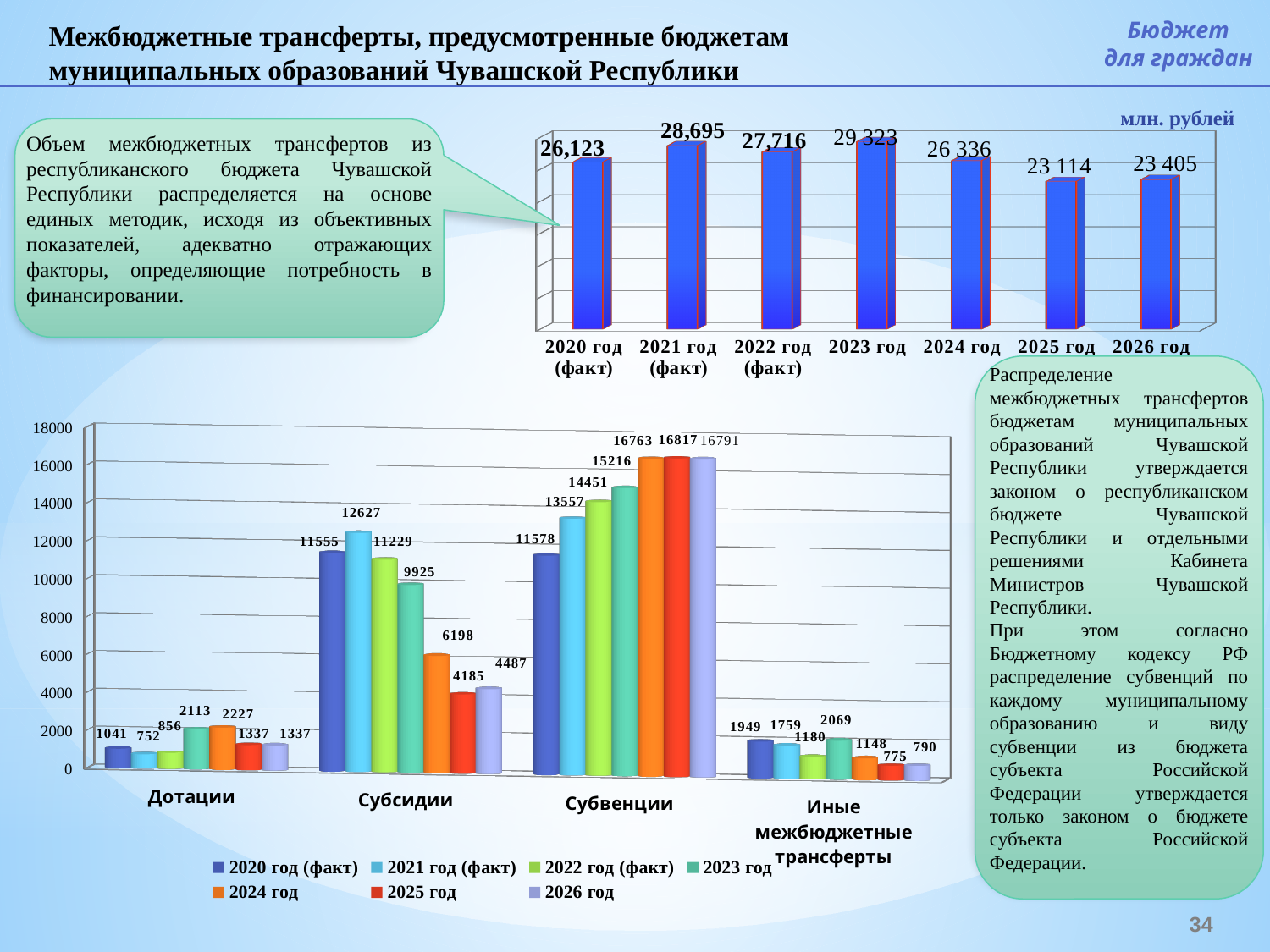
In the top chart, which year has the lowest value? 2025 год In the bottom chart, what is the value for Субвенции in 2025 год? 16817 In the bottom chart, what is the value for Субсидии in 2024 год? 6198 In the bottom chart, which is larger: Дотации in 2023 год or Дотации in 2024 год? 2024 год In the top chart, what is the value for 2021 год (факт)? 28,695 In the top chart, what unit is shown in the upper right corner? млн. рублей In the bottom chart, what is the difference between Субсидии in 2020 год (факт) and Субсидии in 2026 год? 7068 In the bottom chart, how many series does the legend list? 7 In the top chart, how many years are plotted? 7 In the top chart, which year has the highest value? 2023 год What kind of chart is the bottom chart? bar chart In the bottom chart, do the values for Субвенции rise or fall from 2020 год (факт) to 2025 год? rise